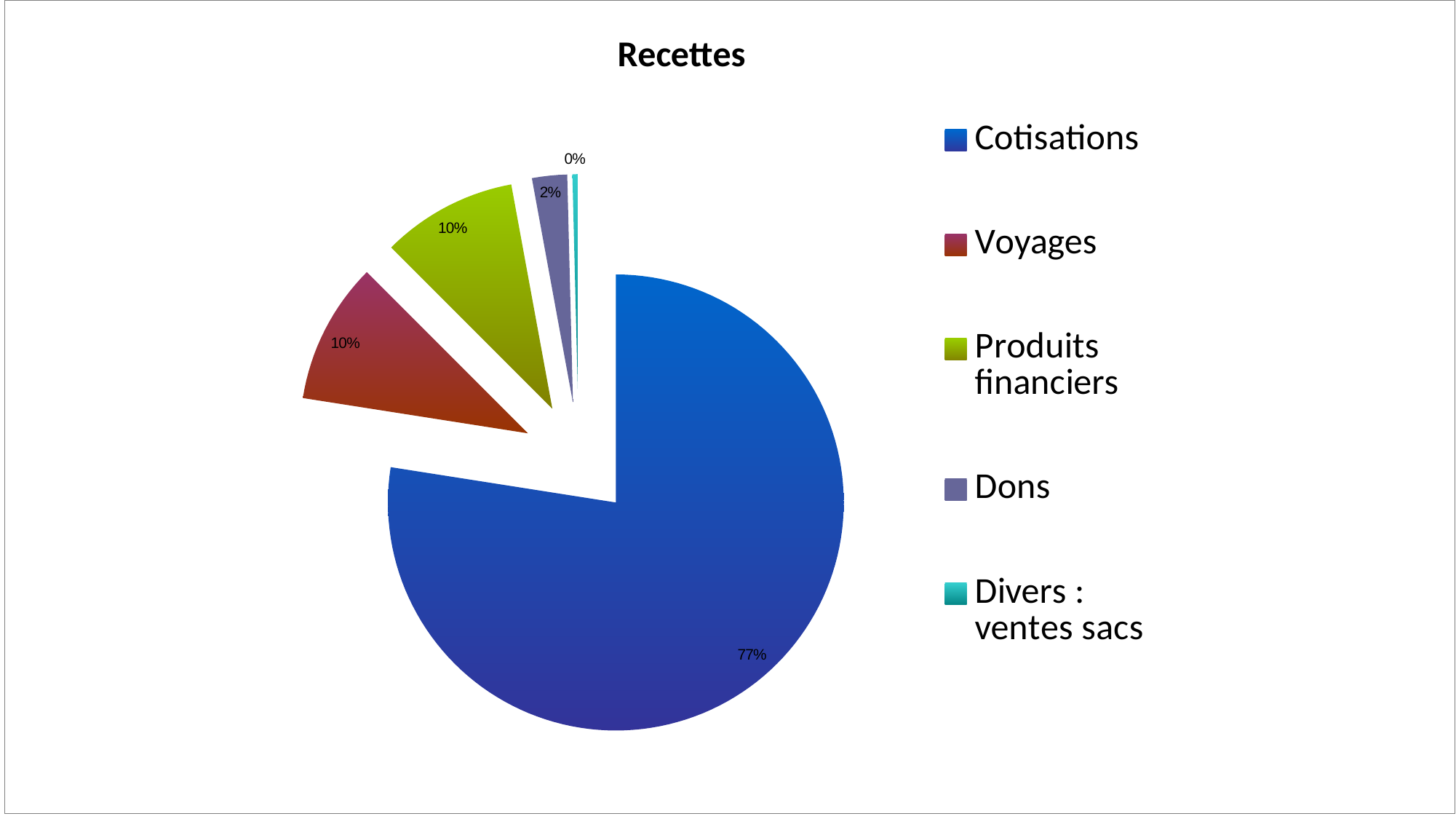
What is the title of the chart? Recettes What share of the pie does Voyages represent? 10% Which is larger, the share for Voyages or the share for Dons? Voyages Which category has the smallest slice of the pie? Divers : ventes sacs What is the difference between the shares of Cotisations and Dons? 75% What share of the pie does Produits financiers represent? 10% What share of the pie does Cotisations represent? 77% How many categories does the pie chart show? 5 What kind of chart is shown on the slide? pie chart Which category has the largest slice of the pie? Cotisations